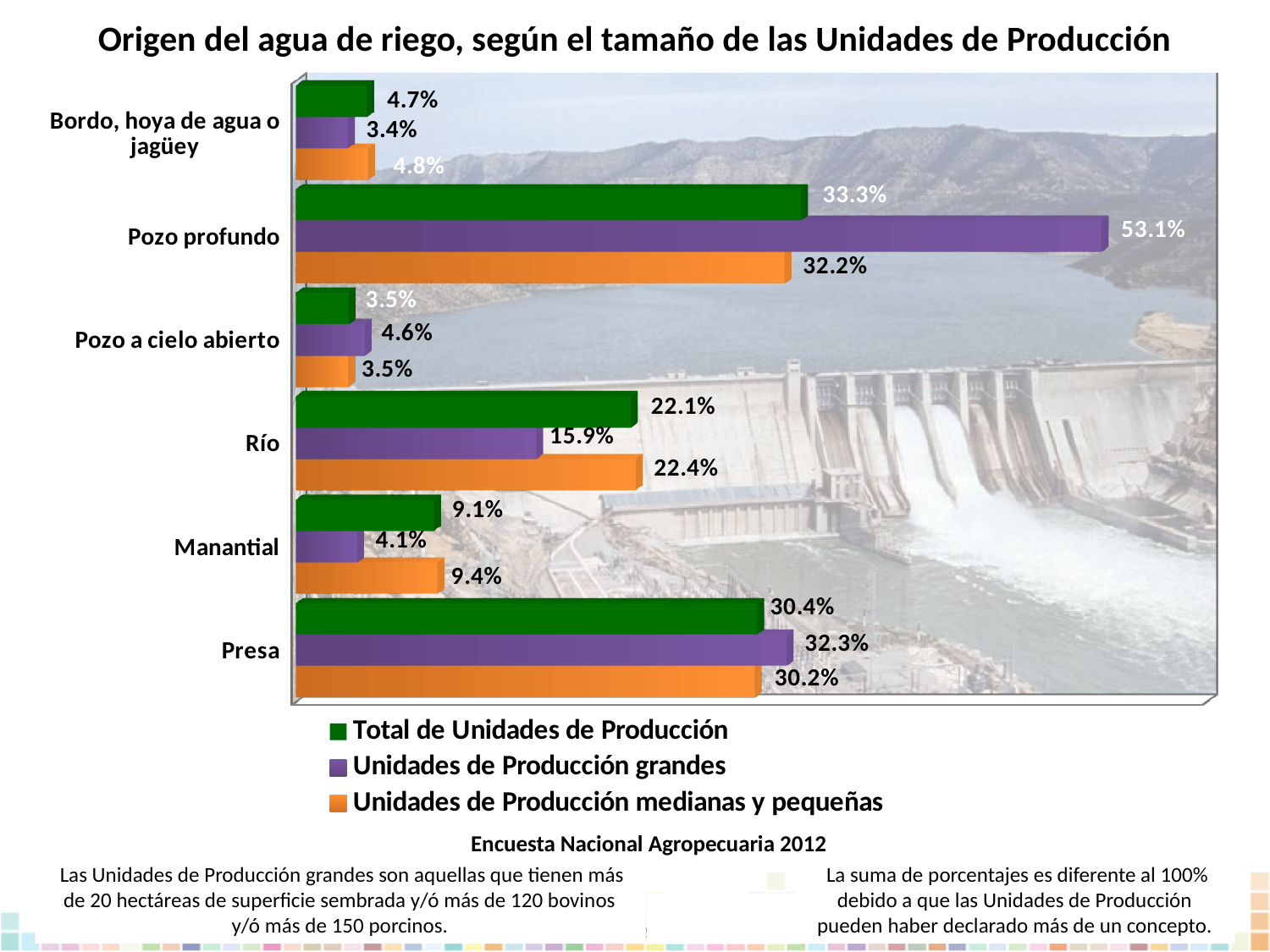
How many water-source categories are shown on the chart? 6 What is the difference between the Total de Unidades de Producción value and the Unidades de Producción grandes value for Manantial? 5.0% Which category has the lowest value in the Total de Unidades de Producción series? Pozo a cielo abierto For Río, which is larger: the Unidades de Producción grandes value or the Unidades de Producción medianas y pequeñas value? Unidades de Producción medianas y pequeñas Which series is shown in orange in the legend? Unidades de Producción medianas y pequeñas What is the value for Manantial in the Unidades de Producción medianas y pequeñas series? 9.4% What is the difference between the Unidades de Producción grandes value and the Total de Unidades de Producción value for Pozo profundo? 19.8% What type of chart is shown on the slide? Bar chart What is the value for Pozo profundo in the Unidades de Producción grandes series? 53.1% Which category has the highest value in the Unidades de Producción grandes series? Pozo profundo What is the value for Río in the Total de Unidades de Producción series? 22.1% How many series does the legend list? 3